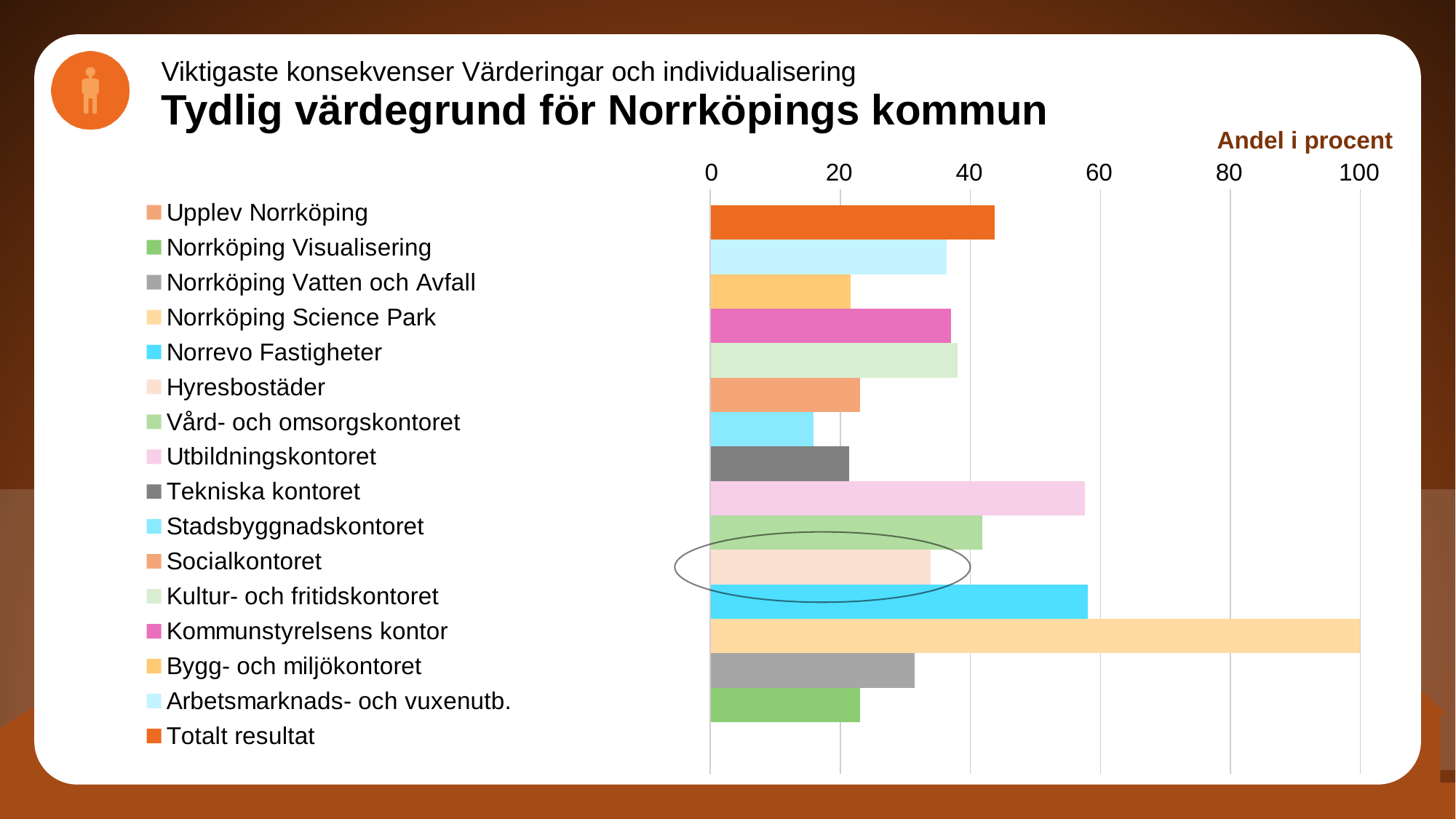
Which category has the highest value in the chart? Norrköping Science Park How many entries does the legend list? 16 What label is shown above the value axis of the chart? Andel i procent Is the value for Norrevo Fastigheter greater or less than 40? greater Which is larger, the value for Norrevo Fastigheter or the value for Hyresbostäder? Norrevo Fastigheter Is the value for Tekniska kontoret greater or less than 40? less Is the value for Stadsbyggnadskontoret greater or less than 20? less What is the value for Norrköping Science Park? 100 Which is larger, the value for Utbildningskontoret or the value for Vård- och omsorgskontoret? Utbildningskontoret What kind of chart is shown on the slide? bar chart